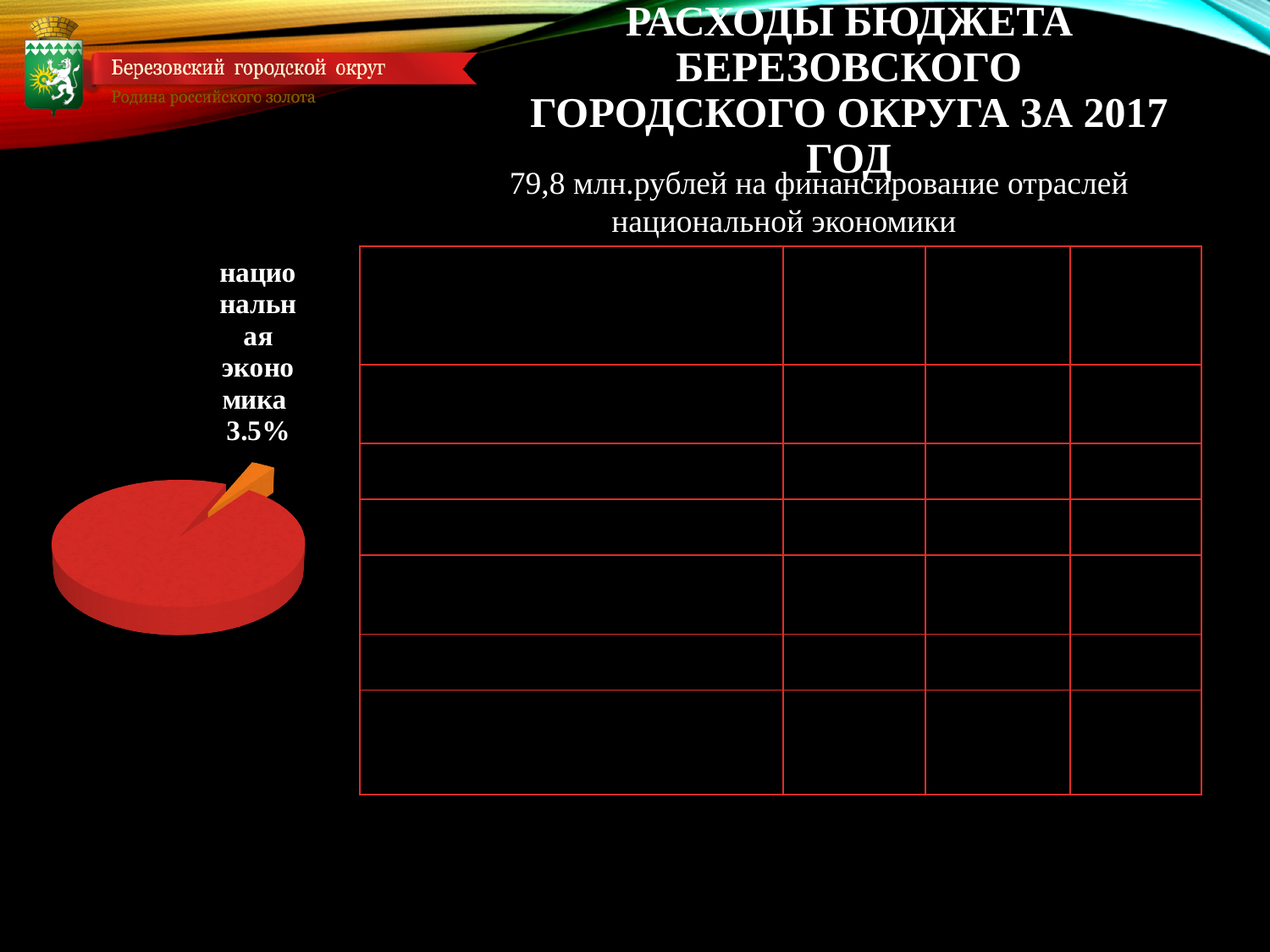
What percentage is printed on the data label of the exploded slice of the pie chart? 3.5% What colour is the exploded "национальная экономика" slice of the pie chart? orange What kind of chart is shown on the left of the slide? pie chart What colour is the large remaining slice of the pie chart? red How many slices are visible in the pie chart? 2 What share of the pie does the slice labelled "национальная экономика" represent? 3.5% Is the "национальная экономика" slice larger or smaller than the remaining part of the pie? smaller